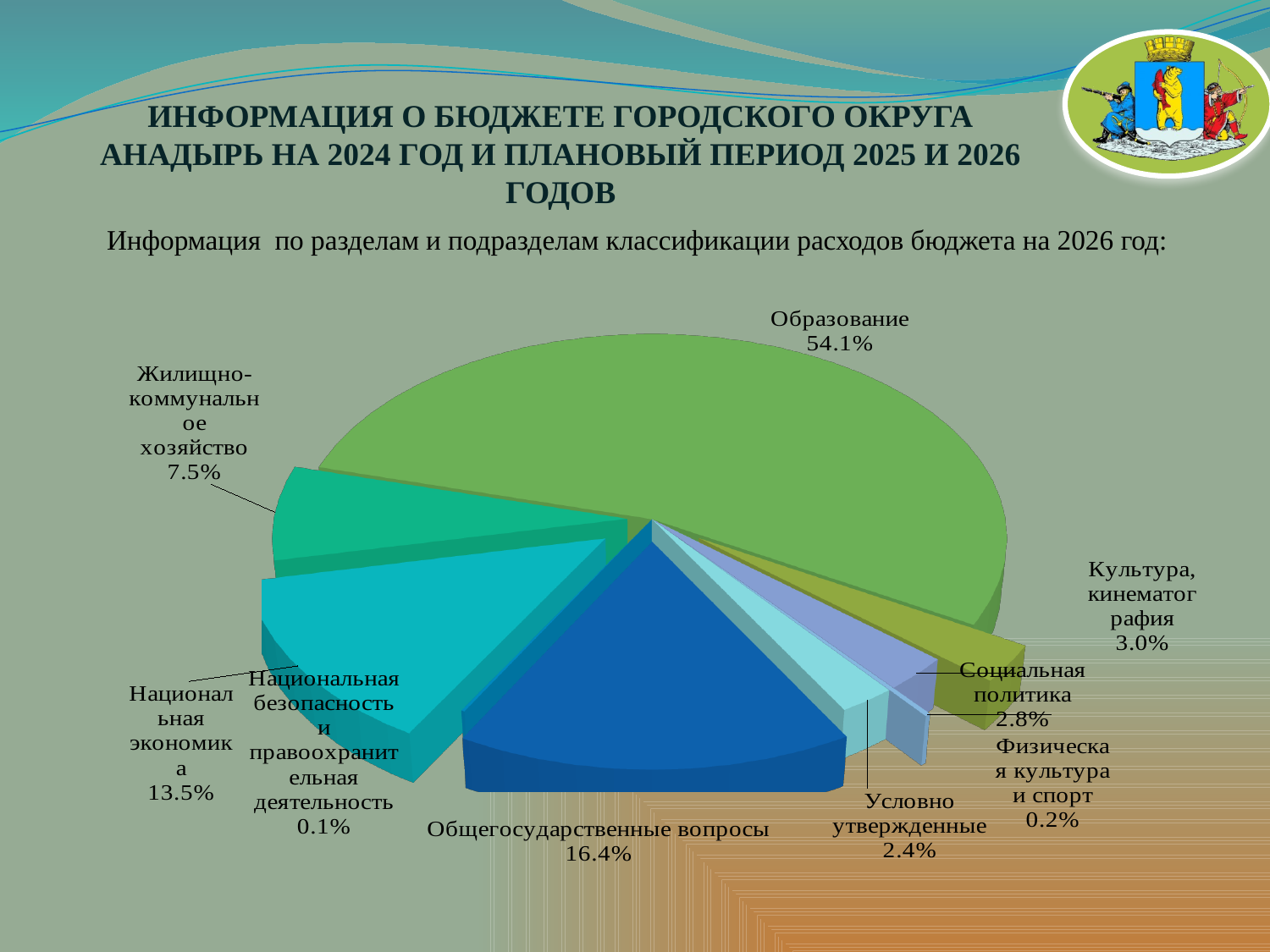
What share of the pie does Образование have? 54.1% What is the difference between the shares of Общегосударственные вопросы and Национальная экономика? 2.9% What value is labelled for Национальная экономика? 13.5% What type of chart is shown on the slide? Pie chart Which is larger: the share of Культура, кинематография or the share of Социальная политика? Культура, кинематография Which category has the smallest share of the pie? Национальная безопасность и правоохранительная деятельность What percentage is shown for Общегосударственные вопросы? 16.4% Which category has the largest share of the pie? Образование Which year does the chart's expenditure breakdown refer to, according to the subtitle? 2026 What share is shown for Жилищно-коммунальное хозяйство? 7.5% What percentage is given for Условно утвержденные? 2.4% How many categories are shown in the pie chart? 9